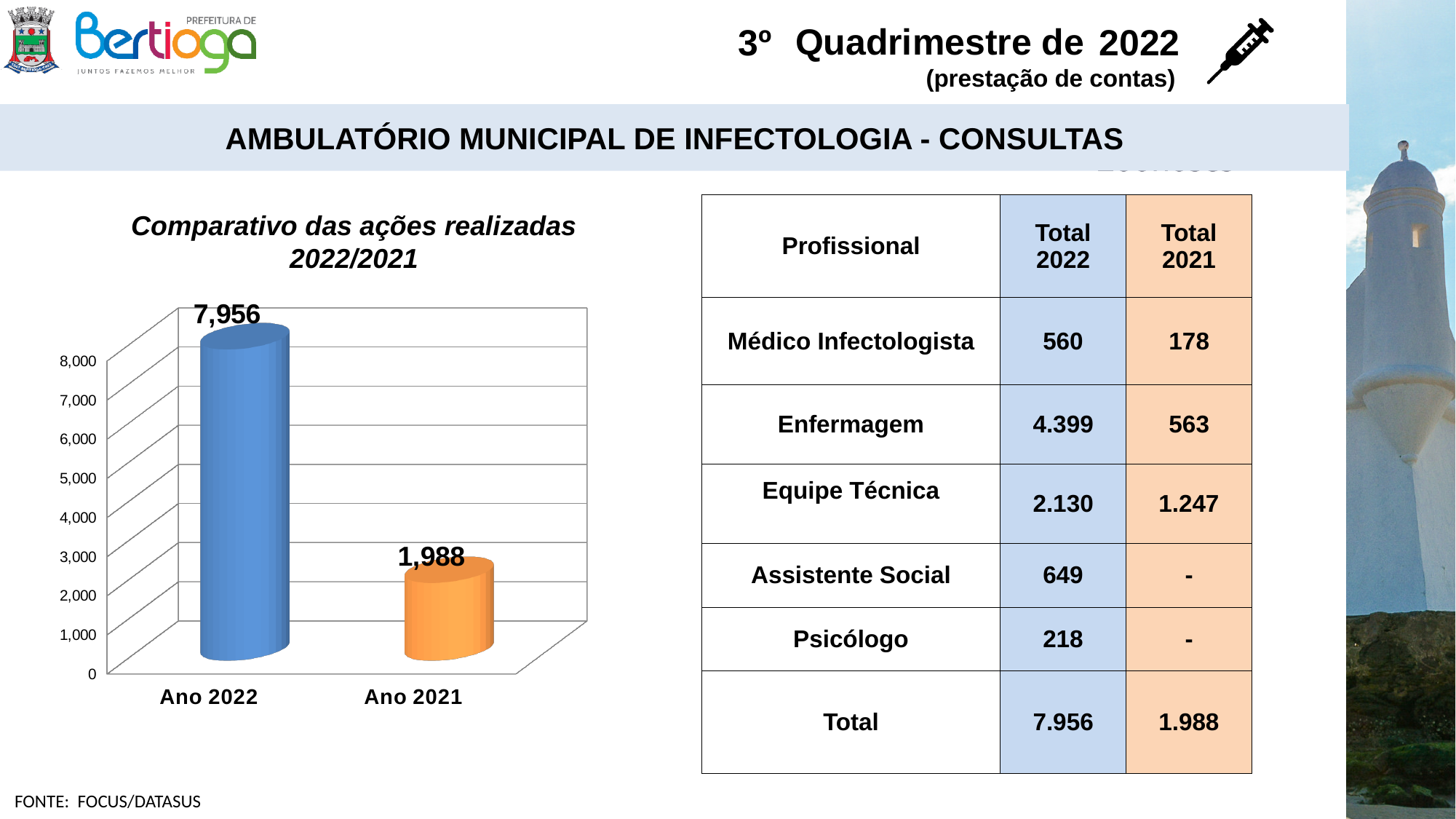
Which category has the highest value in the chart? Ano 2022 What is the value for Ano 2022 in the chart? 7,956 What is the title of the chart? Comparativo das ações realizadas 2022/2021 What is the difference between the values for Ano 2022 and Ano 2021? 5,968 Which category has the lowest value in the chart? Ano 2021 Is the value for Ano 2022 greater or less than 7,000? greater What kind of chart is shown on the slide? bar chart Which is larger, the value for Ano 2022 or the value for Ano 2021? Ano 2022 Is the value for Ano 2021 greater or less than 3,000? less What is the value for Ano 2021 in the chart? 1,988 How many categories are shown in the chart? 2 What colour is the bar for Ano 2021? orange